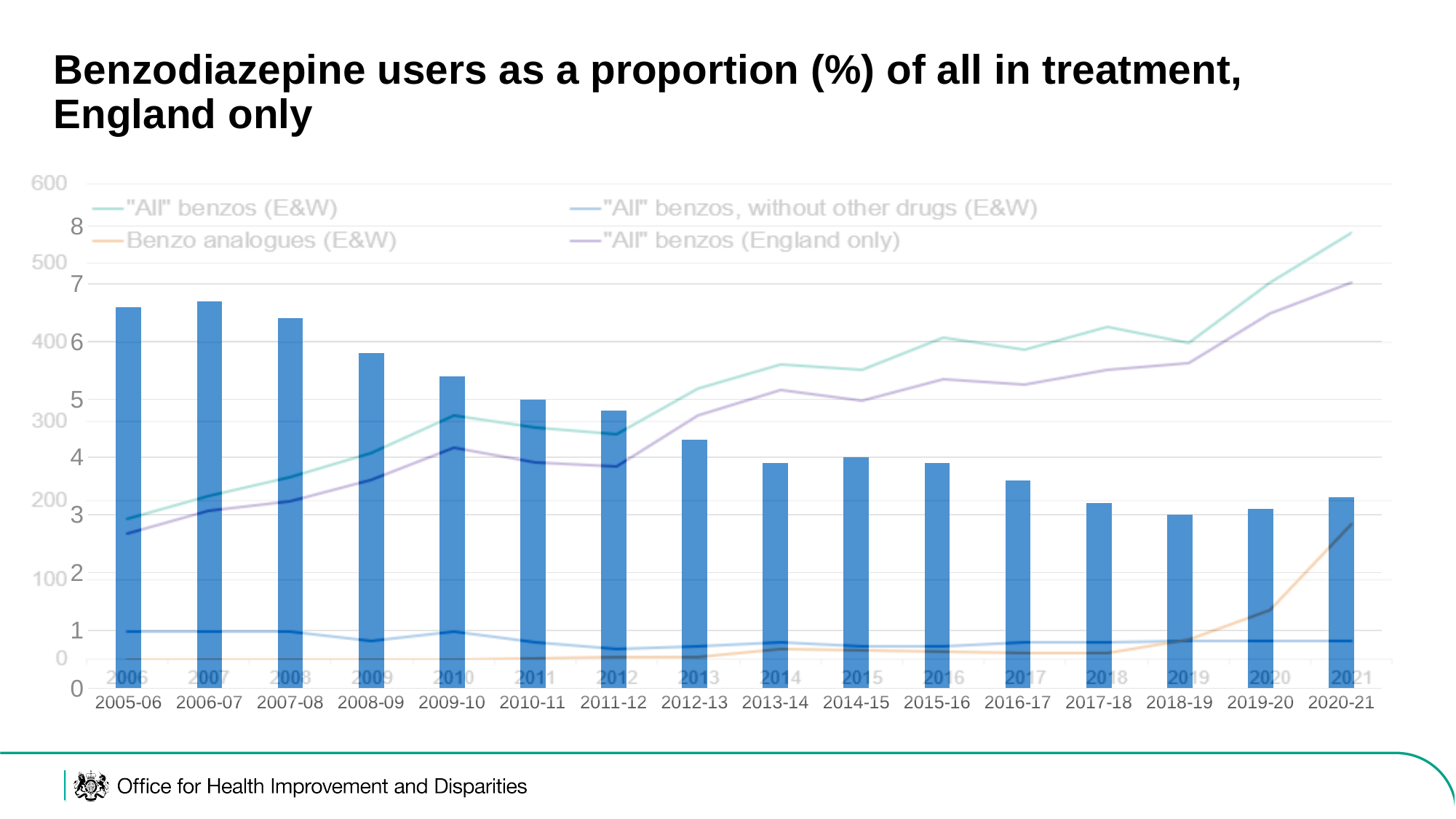
Which year has the highest bar in the chart? 2006-07 Which is larger, the value for 2012-13 or the value for 2016-17? 2012-13 Is the value for 2009-10 greater or less than 5? greater Is the value for 2020-21 greater or less than 4? less Is the value for 2005-06 greater or less than 6? greater How many financial years are shown on the x axis of the bar chart? 16 Which is larger, the value for 2005-06 or the value for 2020-21? 2005-06 What kind of chart is the main chart on the slide? bar chart Do the bar values generally rise or fall from 2005-06 to 2018-19? fall What is the title of the chart? Benzodiazepine users as a proportion (%) of all in treatment, England only